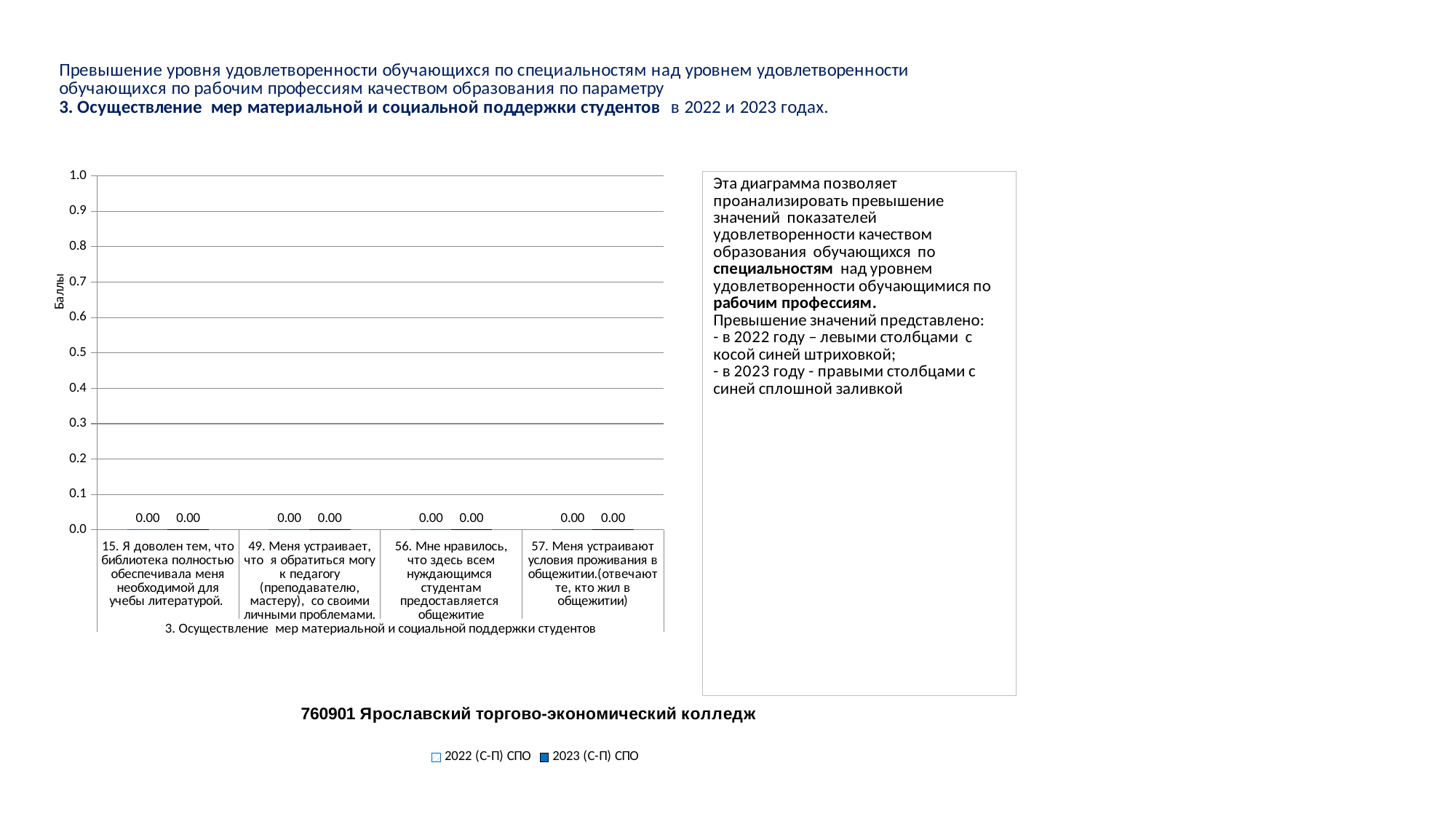
What is the value for the 2023 (С-П) СПО series for category 57 (Меня устраивают условия проживания в общежитии)? 0.00 What are the two series names listed in the chart legend? 2022 (С-П) СПО and 2023 (С-П) СПО What is the value for the 2022 (С-П) СПО series for category 15 (Я доволен тем, что библиотека полностью обеспечивала меня необходимой для учебы литературой)? 0.00 Is the value for the 2023 (С-П) СПО series for category 49 greater or less than 0.5? less What is the label of the vertical axis of the chart? Баллы What kind of chart is shown on the slide? Bar chart How many categories are shown on the x axis of the chart? 4 What is the value for the 2022 (С-П) СПО series for category 49 (Меня устраивает, что я обратиться могу к педагогу)? 0.00 What is the difference between the 2022 (С-П) СПО and 2023 (С-П) СПО values for category 15? 0.00 How many series does the chart legend list? 2 What is the value for the 2023 (С-П) СПО series for category 56 (Мне нравилось, что здесь всем нуждающимся студентам предоставляется общежитие)? 0.00